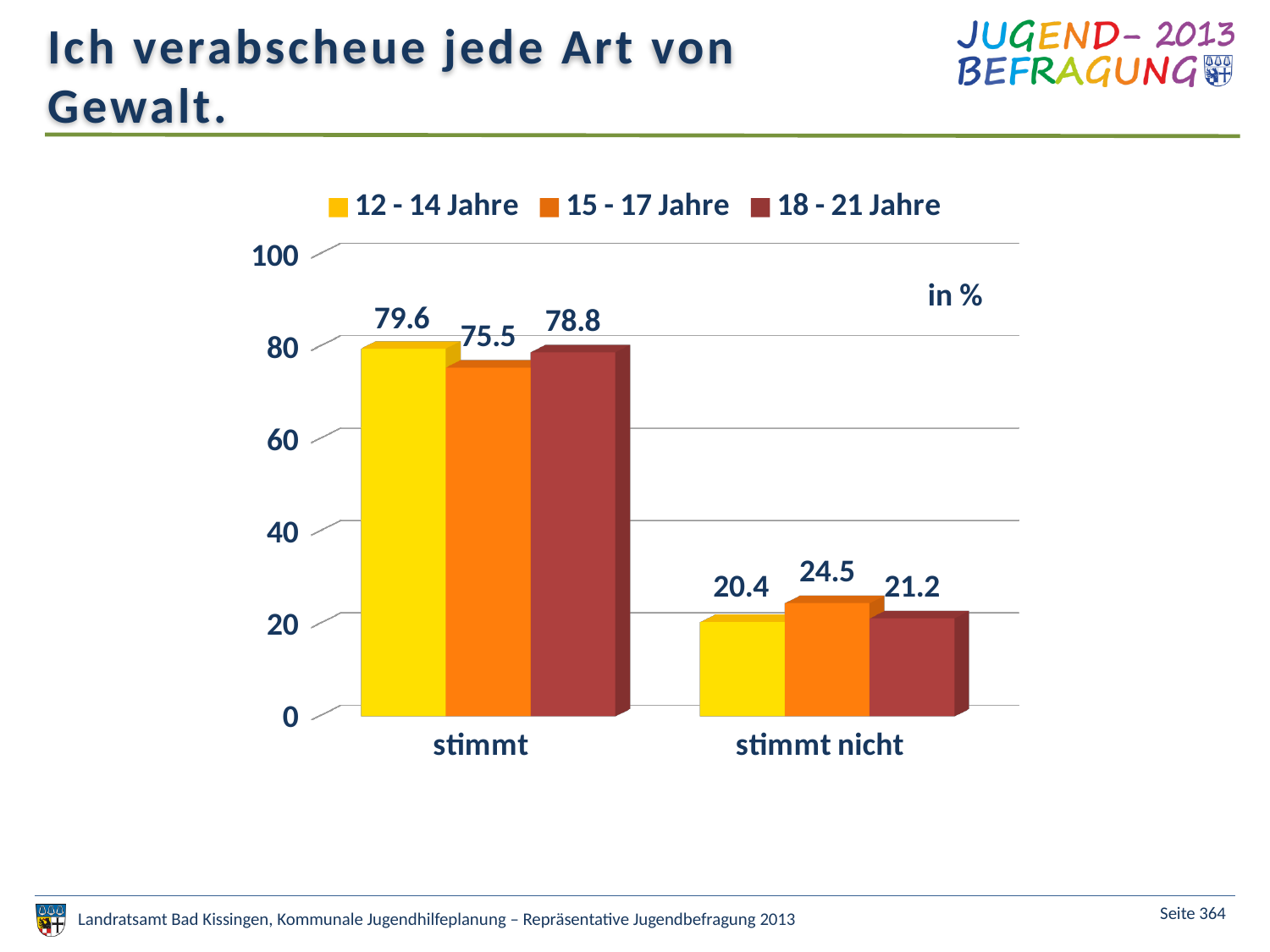
How many series does the legend list? 3 What is the value for the 18 - 21 Jahre series in the "stimmt" category? 78.8 What is the value for the 12 - 14 Jahre series in the "stimmt" category? 79.6 What unit is indicated for the values in the chart? % Is the value for 15 - 17 Jahre in the "stimmt" category greater or less than 60? greater What kind of chart is shown on the slide? bar chart What is the difference between the 12 - 14 Jahre and 15 - 17 Jahre values in the "stimmt" category? 4.1 What is the value for the 15 - 17 Jahre series in the "stimmt nicht" category? 24.5 In the "stimmt nicht" category, which is larger: the value for 15 - 17 Jahre or for 18 - 21 Jahre? 15 - 17 Jahre Which age group has the highest value in the "stimmt" category? 12 - 14 Jahre How many categories are shown on the x axis? 2 Which age group has the lowest value in the "stimmt nicht" category? 12 - 14 Jahre